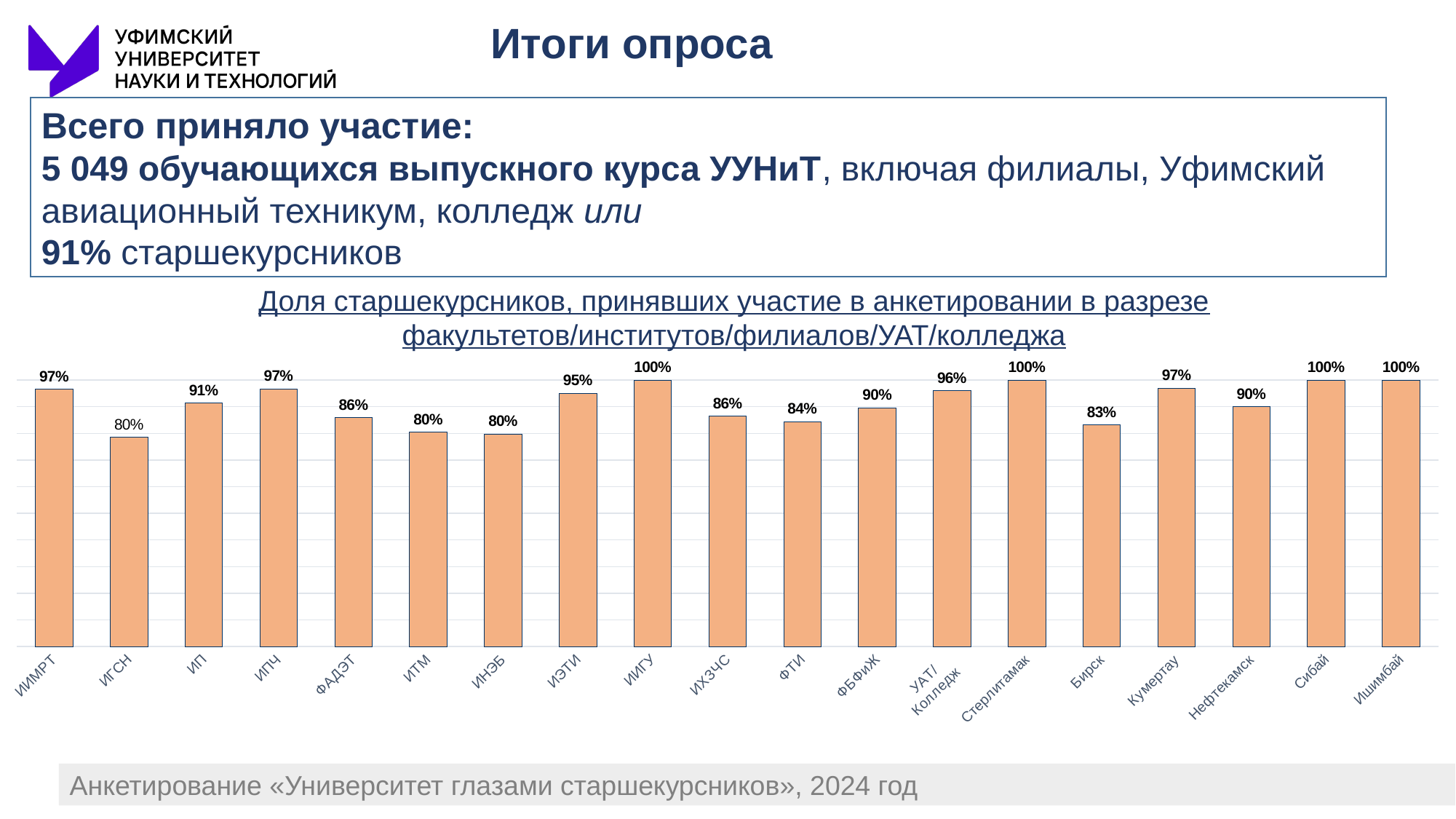
What is the value for Нефтекамск? 90% What is the value for УАТ/Колледж? 96% How many categories have a value of 100%? 4 What is the lowest value shown in the chart? 80% How many categories are shown on the x axis of the chart? 19 Which has a larger value, ИЭТИ or ФБФиЖ? ИЭТИ What is the value for ФАДЭТ? 86% What is the difference between the values for ИИМРТ and ИГСН? 17 percentage points What is the value for Бирск? 83% What is the value for ИИМРТ? 97% What is the highest value shown in the chart? 100% What kind of chart is shown on the slide? Bar chart